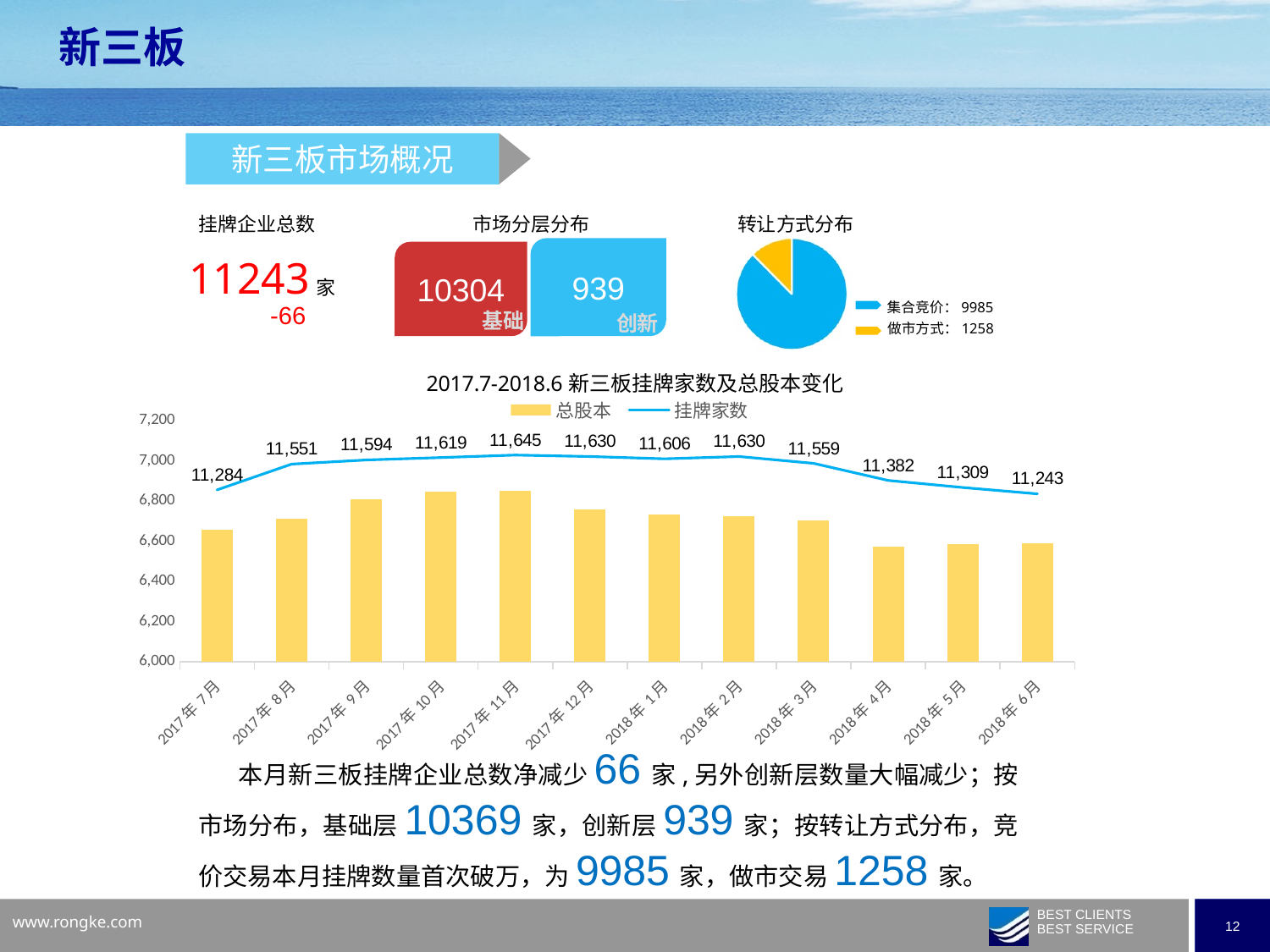
In the chart titled 2017.7-2018.6 新三板挂牌家数及总股本变化, is the 总股本 bar for 2017年11月 greater or less than 6,800? greater In the chart titled 2017.7-2018.6 新三板挂牌家数及总股本变化, which month has the highest 挂牌家数? 2017年11月 How many series does the legend of the chart titled 2017.7-2018.6 新三板挂牌家数及总股本变化 list? 2 In the chart titled 2017.7-2018.6 新三板挂牌家数及总股本变化, which month has the lowest 挂牌家数? 2018年6月 How many months are shown on the x axis of the chart titled 2017.7-2018.6 新三板挂牌家数及总股本变化? 12 In the chart titled 2017.7-2018.6 新三板挂牌家数及总股本变化, is the 挂牌家数 higher in 2018年3月 or 2018年5月? 2018年3月 In the chart titled 2017.7-2018.6 新三板挂牌家数及总股本变化, is the 总股本 bar for 2018年4月 greater or less than 6,600? less In the chart titled 2017.7-2018.6 新三板挂牌家数及总股本变化, what is the 挂牌家数 value for 2017年11月? 11,645 In the chart titled 2017.7-2018.6 新三板挂牌家数及总股本变化, does the 挂牌家数 line rise or fall from 2018年2月 to 2018年6月? fall In the chart titled 2017.7-2018.6 新三板挂牌家数及总股本变化, what is the 挂牌家数 value for 2018年4月? 11,382 In the pie chart titled 转让方式分布, which slice is larger, 集合竞价 or 做市方式? 集合竞价 In the chart titled 2017.7-2018.6 新三板挂牌家数及总股本变化, what is the difference in 挂牌家数 between 2017年7月 and 2017年8月? 267